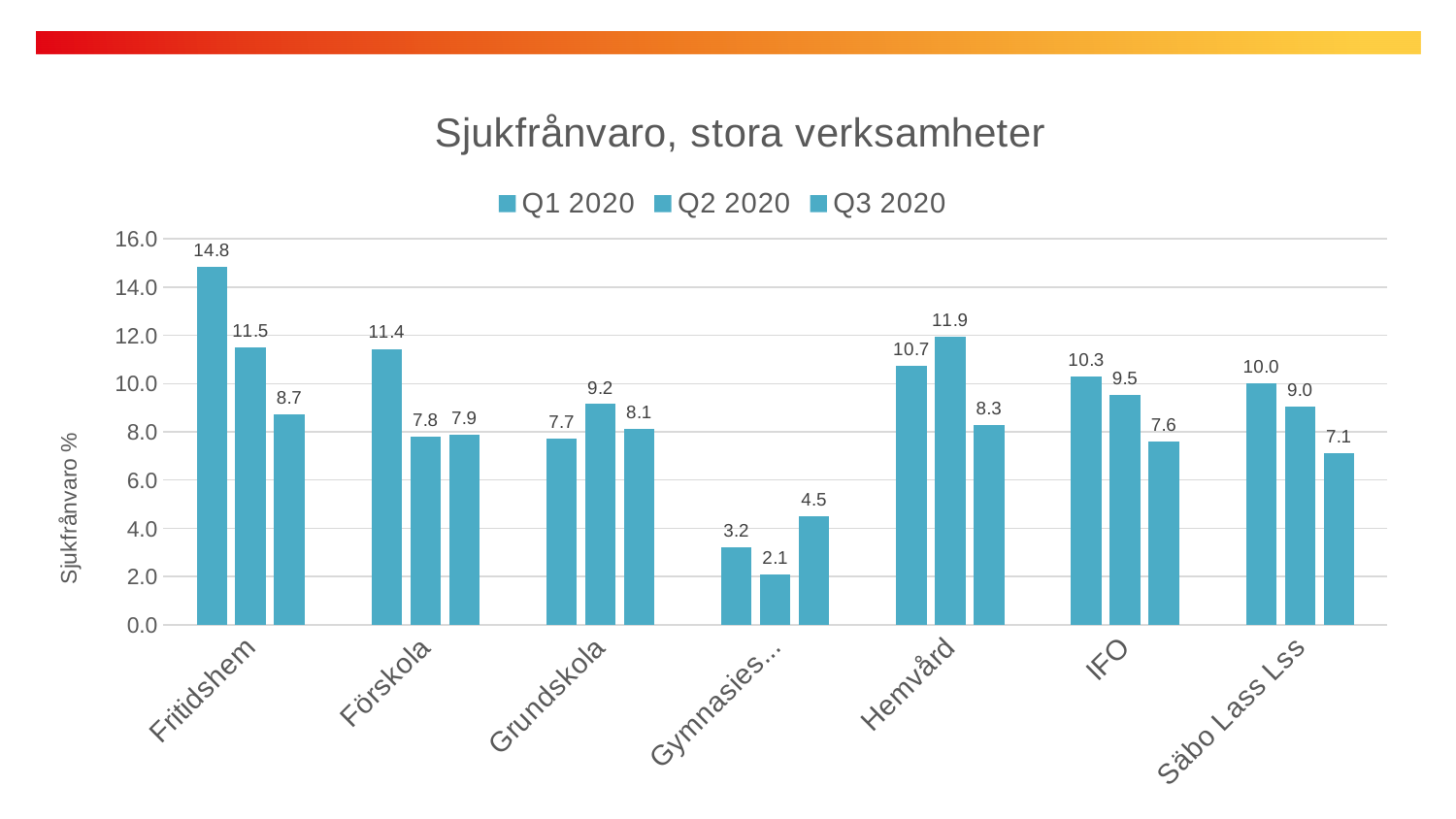
Which category has the highest Q2 2020 value? Hemvård What kind of chart is shown on the slide? bar chart What is the difference between the Q1 2020 and Q3 2020 values for Fritidshem? 6.1 Which has the larger Q1 2020 value, Förskola or Grundskola? Förskola What is the Q3 2020 value for Hemvård? 8.3 Which category has the highest Q1 2020 value? Fritidshem What is the Q1 2020 value for Fritidshem? 14.8 What is the Q2 2020 value for IFO? 9.5 How many series does the legend list? 3 How many categories are shown on the x axis? 7 What is the difference between the Q2 2020 and Q1 2020 values for Hemvård? 1.2 Is the Q2 2020 value for Grundskola greater or less than 8.0? greater